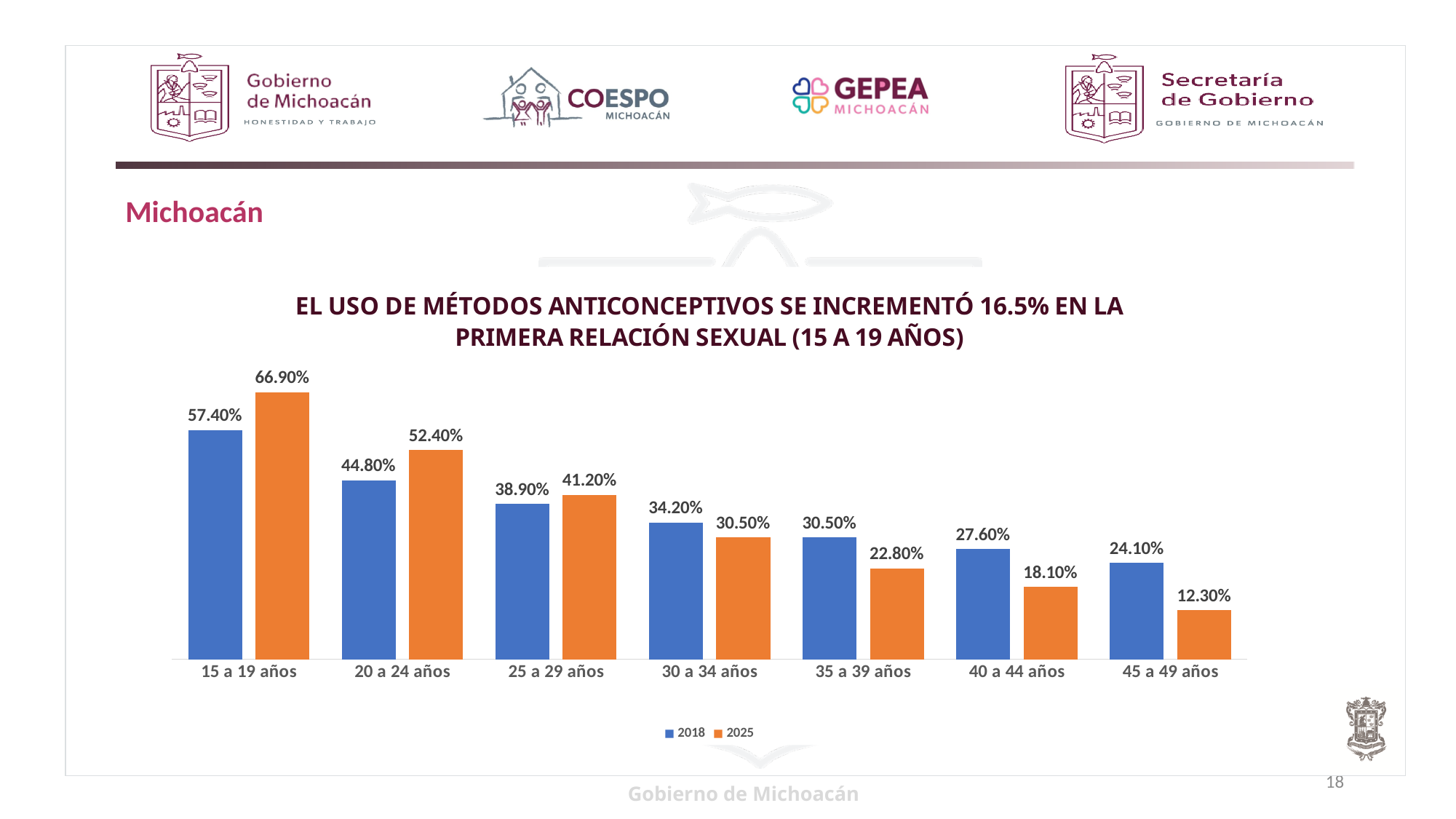
What kind of chart is shown on the slide? Bar chart What is the 2025 value for the 45 a 49 años group? 12.30% Which age group has the highest 2018 value? 15 a 19 años What is the difference between the 2025 and 2018 values for the 20 a 24 años group? 7.60% Do the 2018 values rise or fall as the age groups increase along the x axis? Fall For the 40 a 44 años group, which year has the larger value, 2018 or 2025? 2018 What is the 2018 value for the 35 a 39 años group? 30.50% What is the 2025 value for the 15 a 19 años group? 66.90% How many series does the legend list? 2 How many age groups are shown on the x axis? 7 For the 25 a 29 años group, which year has the larger value, 2018 or 2025? 2025 Which age group has the lowest 2025 value? 45 a 49 años